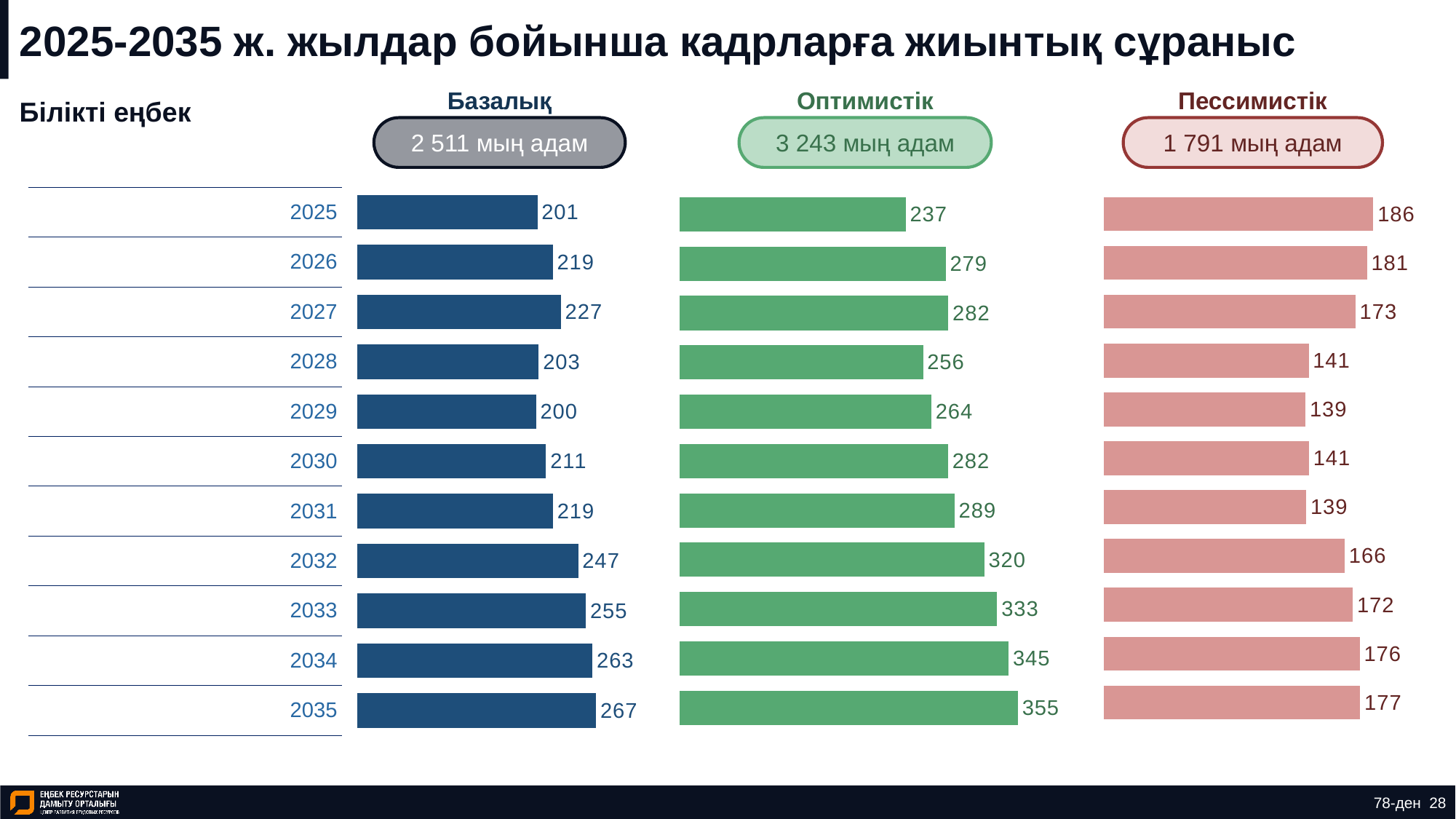
What type of chart is used for the Оптимистік scenario? Bar chart In the Оптимистік chart, what is the value for 2032? 320 What total is shown in the label above the Пессимистік chart? 1 791 мың адам How many years are shown in the Базалық chart? 11 In the Базалық chart, what is the value for 2027? 227 In the Пессимистік chart, which year has the highest value? 2025 In the Оптимистік chart, what is the difference between the values for 2034 and 2033? 12 In the Оптимистік chart, which year has the highest value? 2035 In the Пессимистік chart, what is the value for 2025? 186 In the Базалық chart, what is the difference between the values for 2035 and 2025? 66 In the Пессимистік chart, which is larger, the value for 2026 or the value for 2033? 2026 In the Базалық chart, which year has the lowest value? 2029